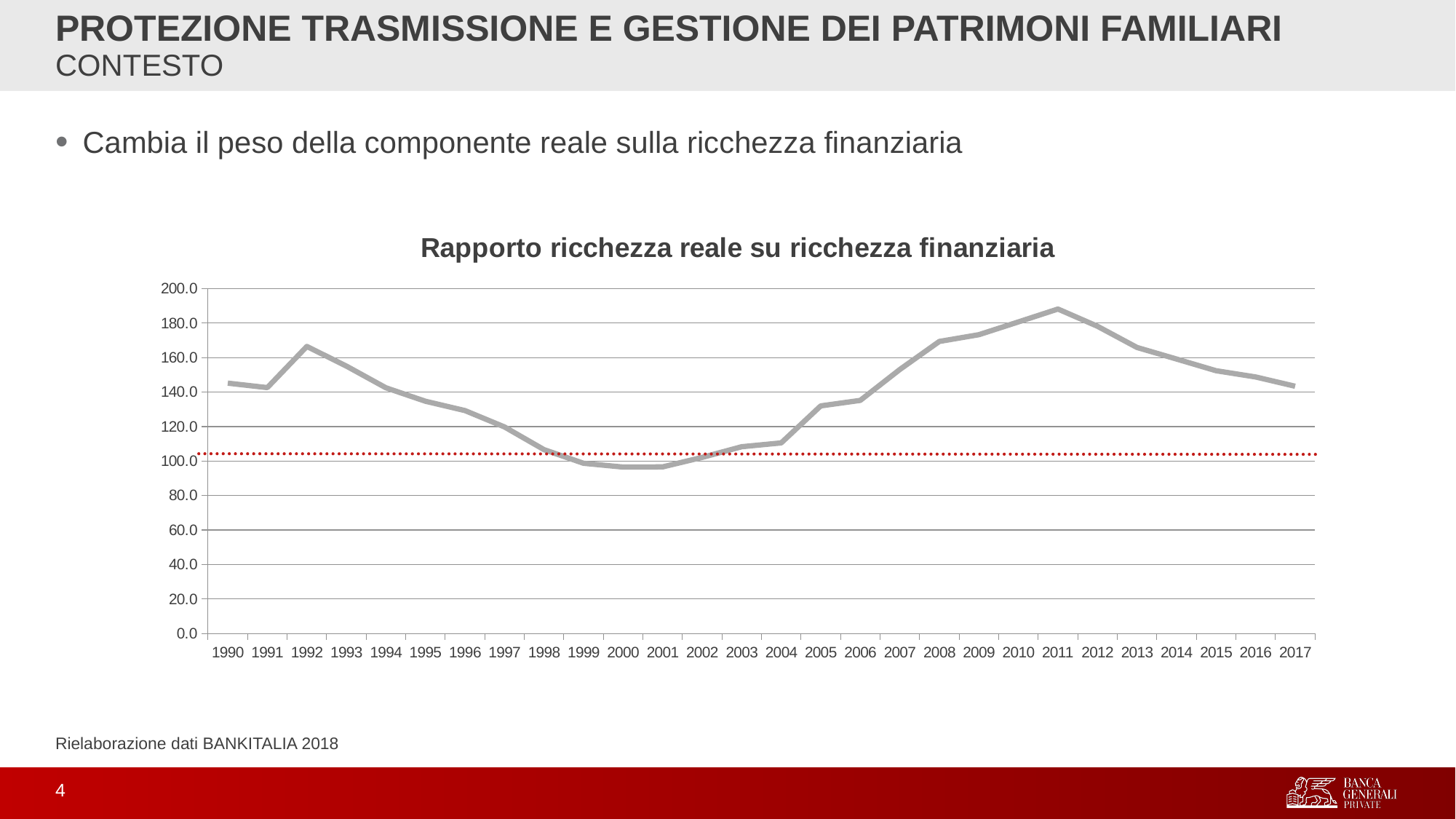
Which year has the larger value, 1990 or 2000? 1990 Is the value for 2005 greater or less than 120? greater Is the value for 2011 greater or less than 180? greater What kind of chart is shown on the slide? line chart Is the value for 2000 greater or less than 100? less What is the title of the chart? Rapporto ricchezza reale su ricchezza finanziaria Does the ratio rise or fall between 2011 and 2017? fall How many years are plotted along the x axis of the chart? 28 In which year does the ratio reach its highest value? 2011 What colour is the dotted horizontal reference line on the chart? red